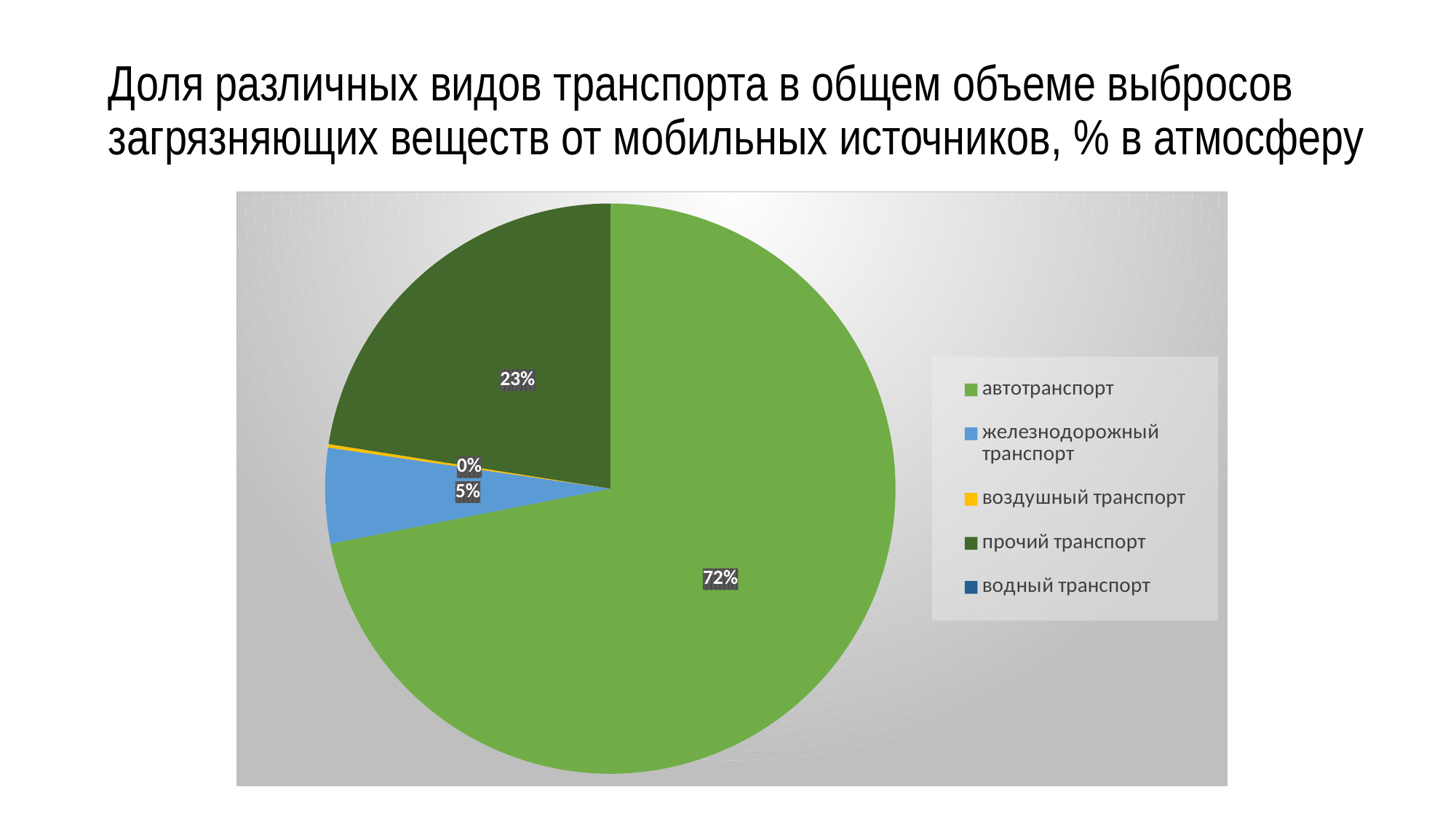
What type of chart is shown on the slide? Pie chart By how many percentage points does the share of прочий транспорт exceed that of железнодорожный транспорт? 18 percentage points What share of emissions does железнодорожный транспорт account for? 5% What share of emissions does прочий транспорт account for? 23% Which type of transport has the largest share of emissions? автотранспорт What colour represents железнодорожный транспорт in the chart? Blue Which has a larger share: прочий транспорт or железнодорожный транспорт? прочий транспорт What share of emissions does автотранспорт account for? 72% What share of emissions does воздушный транспорт account for? 0% Is the share of автотранспорт greater or less than 50%? greater By how many percentage points does the share of автотранспорт exceed that of прочий транспорт? 49 percentage points How many categories does the legend list? 5